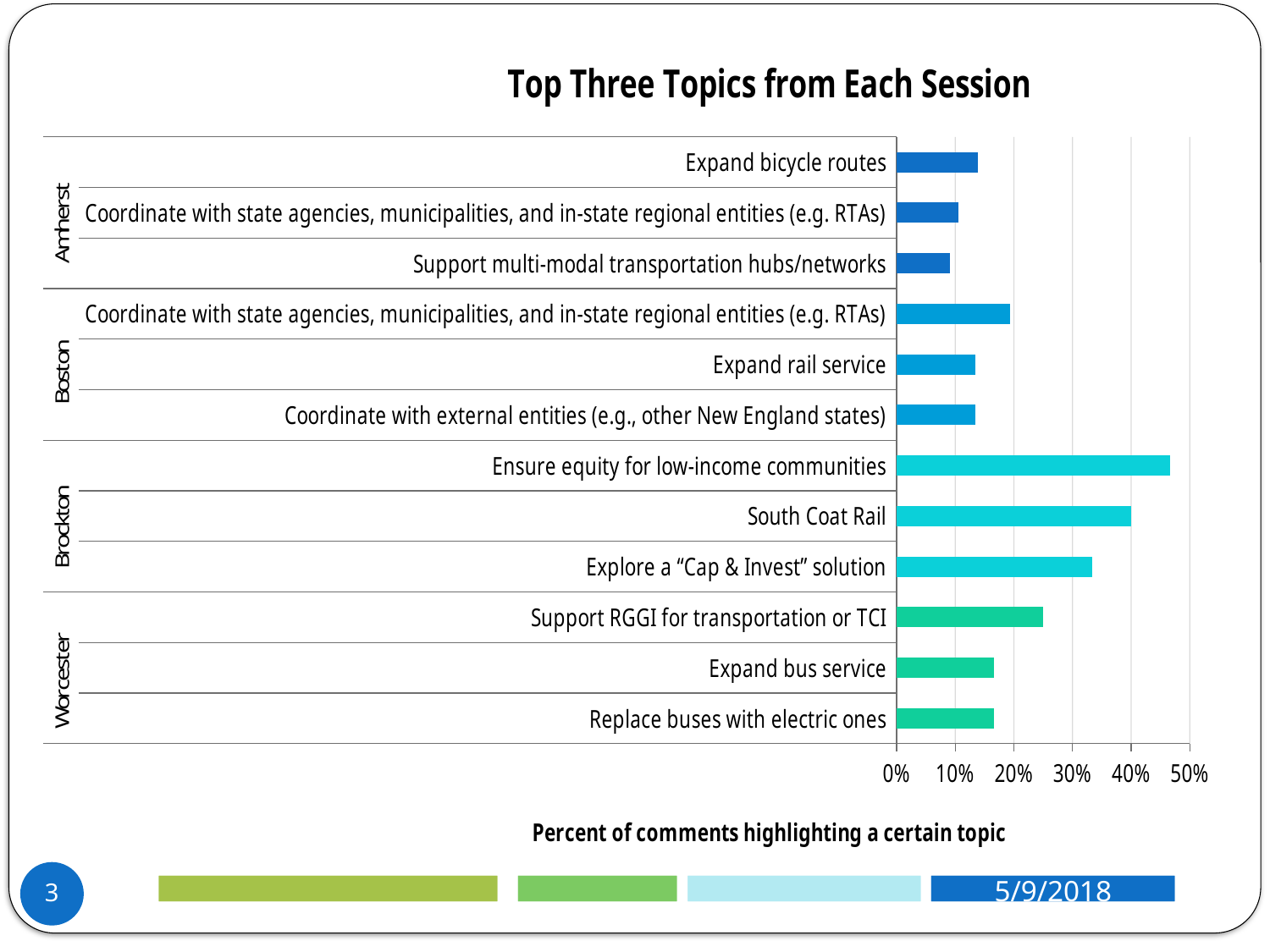
What kind of chart is shown on the slide? Bar chart Is the value for Support multi-modal transportation hubs/networks greater or less than 10%? less Which topic has the highest percentage of comments? Ensure equity for low-income communities What is the title of the chart? Top Three Topics from Each Session Which has a larger value: Support RGGI for transportation or TCI, or Expand bus service? Support RGGI for transportation or TCI Is the value for Support RGGI for transportation or TCI greater or less than 20%? greater What is the label on the horizontal axis of the chart? Percent of comments highlighting a certain topic How many sessions are listed as groups along the vertical axis? 4 How many bars are plotted in the chart? 12 Which has a larger value: Ensure equity for low-income communities or South Coat Rail? Ensure equity for low-income communities Is the value for Ensure equity for low-income communities greater or less than 40%? greater Which topic has the lowest percentage of comments? Support multi-modal transportation hubs/networks